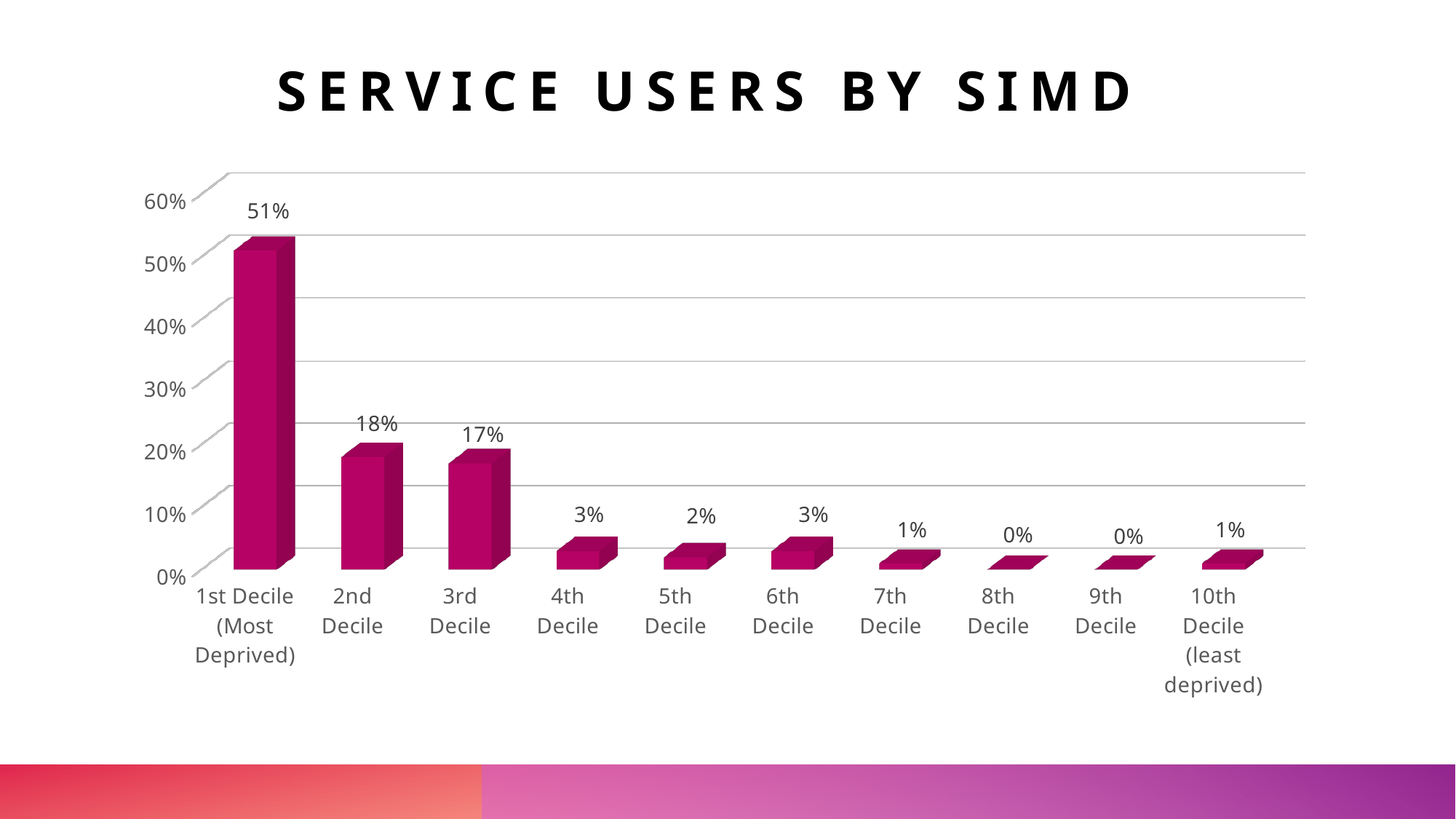
What is the value for the 5th Decile? 2% Is the value for the 1st Decile greater or less than 50%? greater Which is larger, the value for the 4th Decile or the 5th Decile? 4th Decile Which decile has the highest share of service users? 1st Decile (Most Deprived) What percentage of service users are in the 1st Decile (Most Deprived)? 51% What is the difference between the values for the 2nd Decile and the 3rd Decile? 1% What is the value for the 3rd Decile? 17% What is the title of the chart? Service Users by SIMD How many deciles are shown on the x axis? 10 What kind of chart is shown on the slide? Bar chart What is the difference between the values for the 1st Decile and the 2nd Decile? 33% What is the value for the 10th Decile (least deprived)? 1%